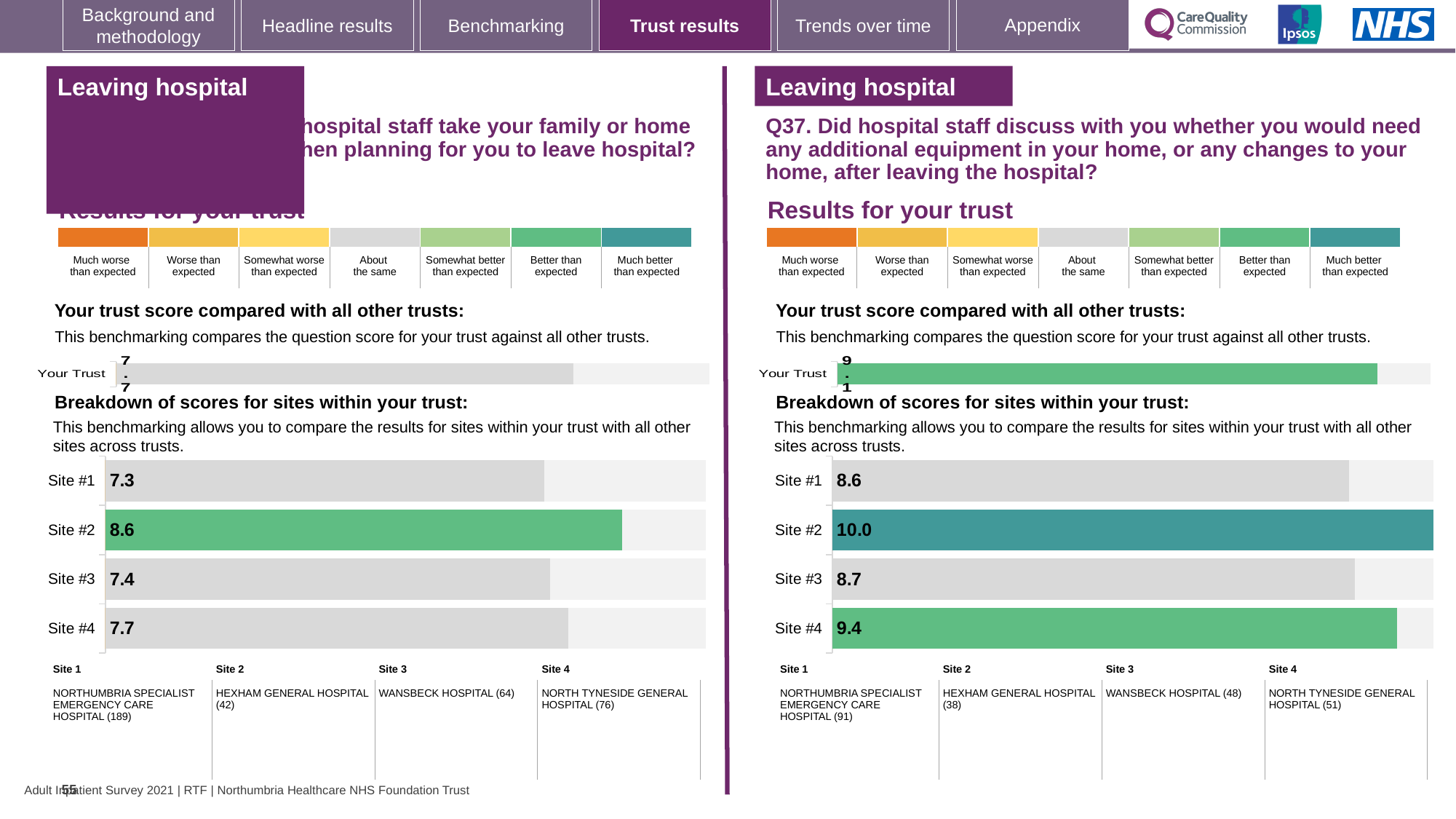
On the right-hand (Q37) chart, what is the 'Your Trust' score? 9.1 On the right-hand (Q37) site breakdown chart, which site has the highest score? Site #2 On the left-hand site breakdown chart, what is the score for Site #2? 8.6 On the right-hand (Q37) site breakdown chart, what is the score for Site #4? 9.4 On the right-hand (Q37) site breakdown chart, is the score for Site #1 or Site #4 larger? Site #4 On the left-hand site breakdown chart, what is the difference between the scores for Site #2 and Site #1? 1.3 How many sites are shown in the left-hand site breakdown chart? 4 On the right-hand (Q37) site breakdown chart, what is the difference between the scores for Site #2 and Site #3? 1.3 On the left-hand chart, what is the 'Your Trust' score? 7.7 On the right-hand (Q37) site breakdown chart, which site has the lowest score? Site #1 On the left-hand site breakdown chart, which site has the lowest score? Site #1 What type of chart is used for the site breakdown on the right-hand (Q37) side? Bar chart